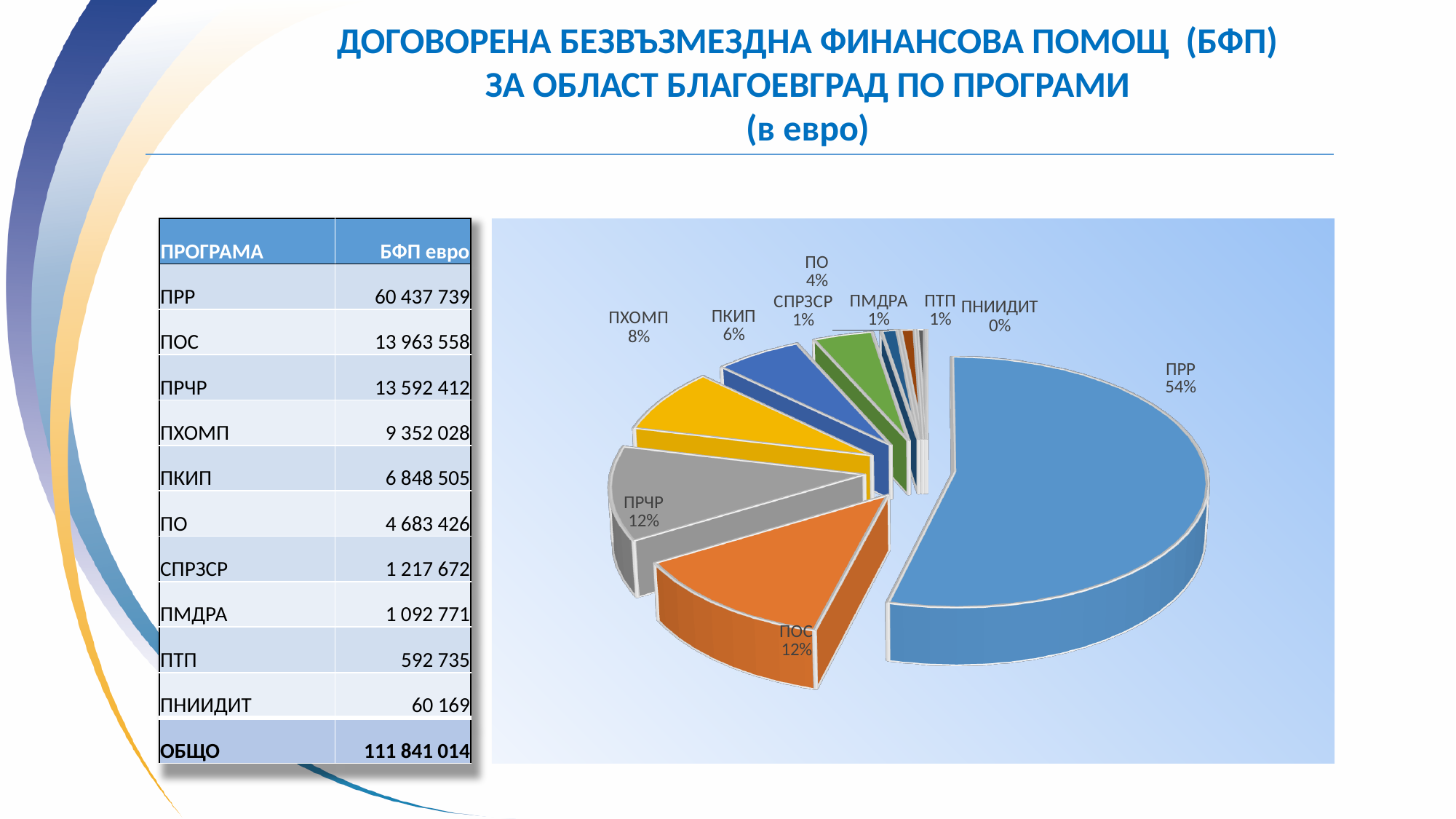
What share of the pie does ПНИИДИТ hold? 0% Which program has the largest slice of the pie? ПРР Which slice is larger, ПХОМП or ПКИП? ПХОМП What is the difference in percentage points between the ПРР slice and the ПОС slice? 42 How many slices does the pie chart have? 10 What share of the pie does ПКИП hold? 6% What share of the pie does ПРР hold? 54% Which program has the smallest slice of the pie? ПНИИДИТ What type of chart is shown on the slide? pie chart What colour is the ПОС slice of the pie? orange